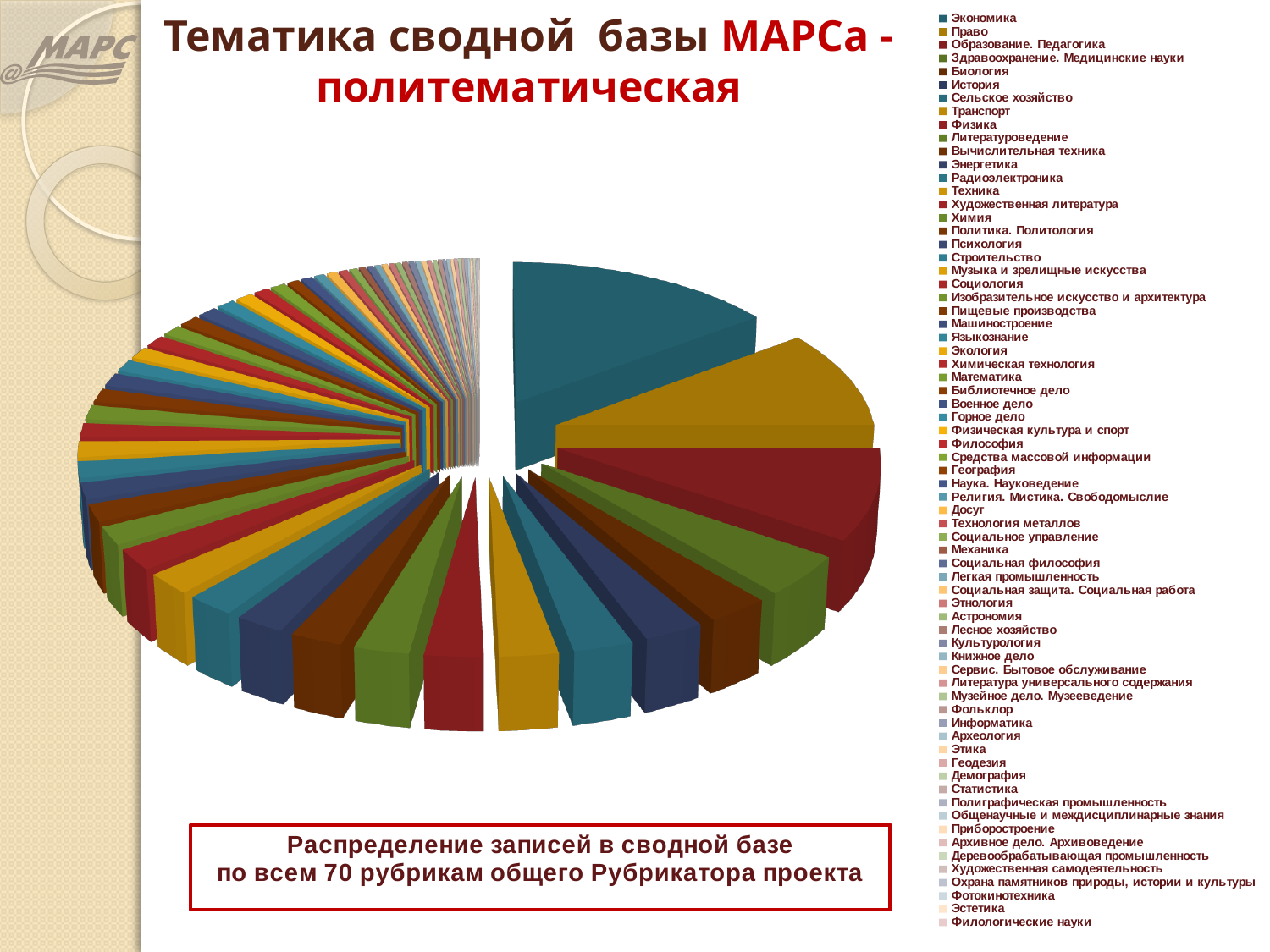
Which slice is larger, Экономика or Здравоохранение. Медицинские науки? Экономика Which rubric has the largest slice in the pie chart? Экономика Which slice is larger, Экономика or Право? Экономика According to the caption, across how many rubrics are the records distributed? 70 Which rubric is listed first in the legend? Экономика What kind of chart is shown on the slide? pie chart Which slice is larger, Право or Фольклор? Право Which rubric is listed last in the legend? Филологические науки